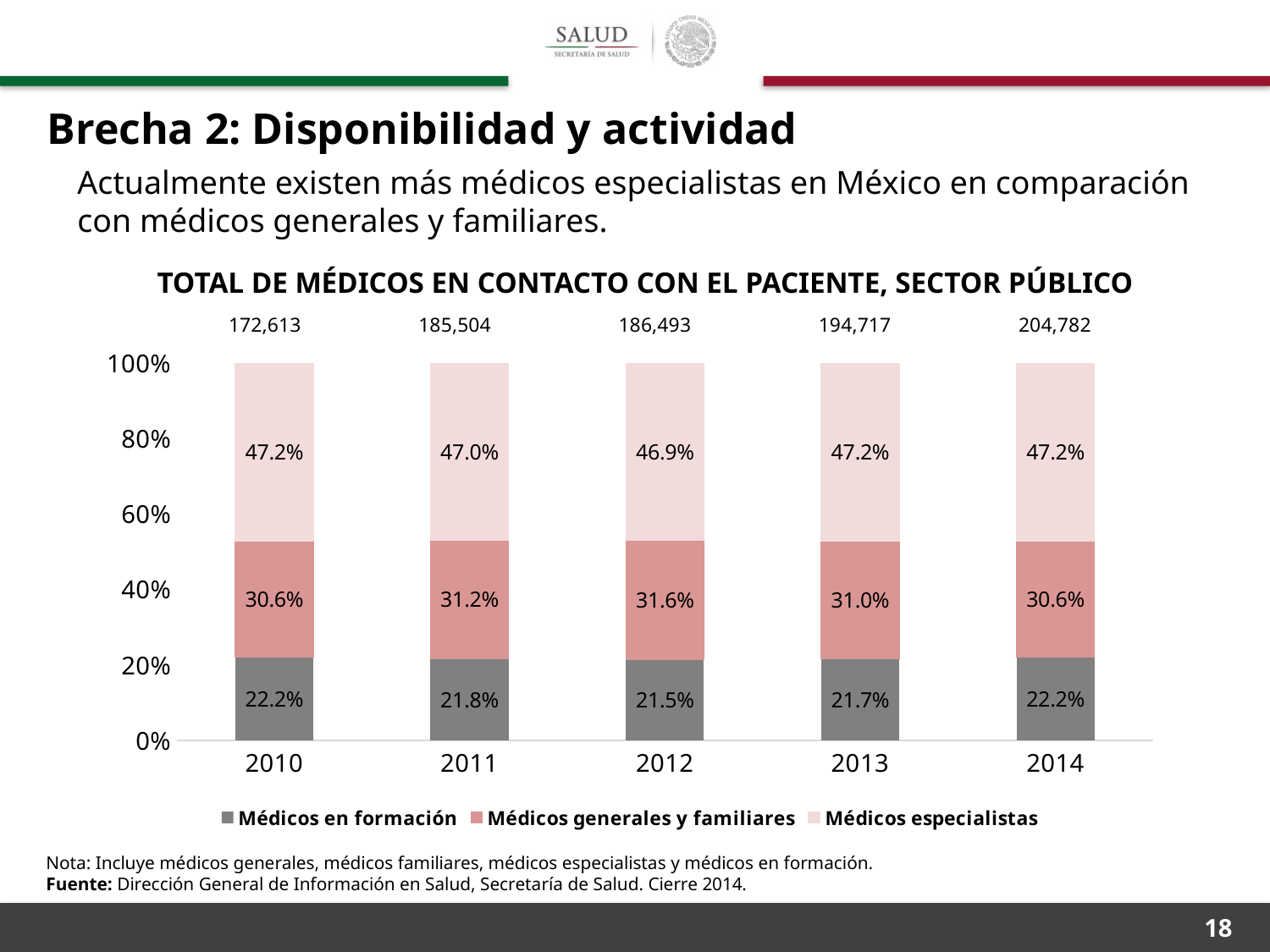
What is the total number of doctors shown above the bar for 2014? 204,782 What share of doctors were Médicos en formación in 2011? 21.8% How many series does the legend list? 3 What is the difference between the share of Médicos especialistas and Médicos generales y familiares in 2010? 16.6% What share of doctors were Médicos especialistas in 2012? 46.9% In which year is the share of Médicos en formación lowest? 2012 Do the total numbers of doctors printed above the bars rise or fall from 2010 to 2014? Rise How many years are shown on the x axis? 5 In which year is the share of Médicos generales y familiares highest? 2012 Which is larger in 2014: the share of Médicos especialistas or the share of Médicos en formación? Médicos especialistas What share of doctors were Médicos generales y familiares in 2013? 31.0% What kind of chart is shown on the slide? Stacked bar chart